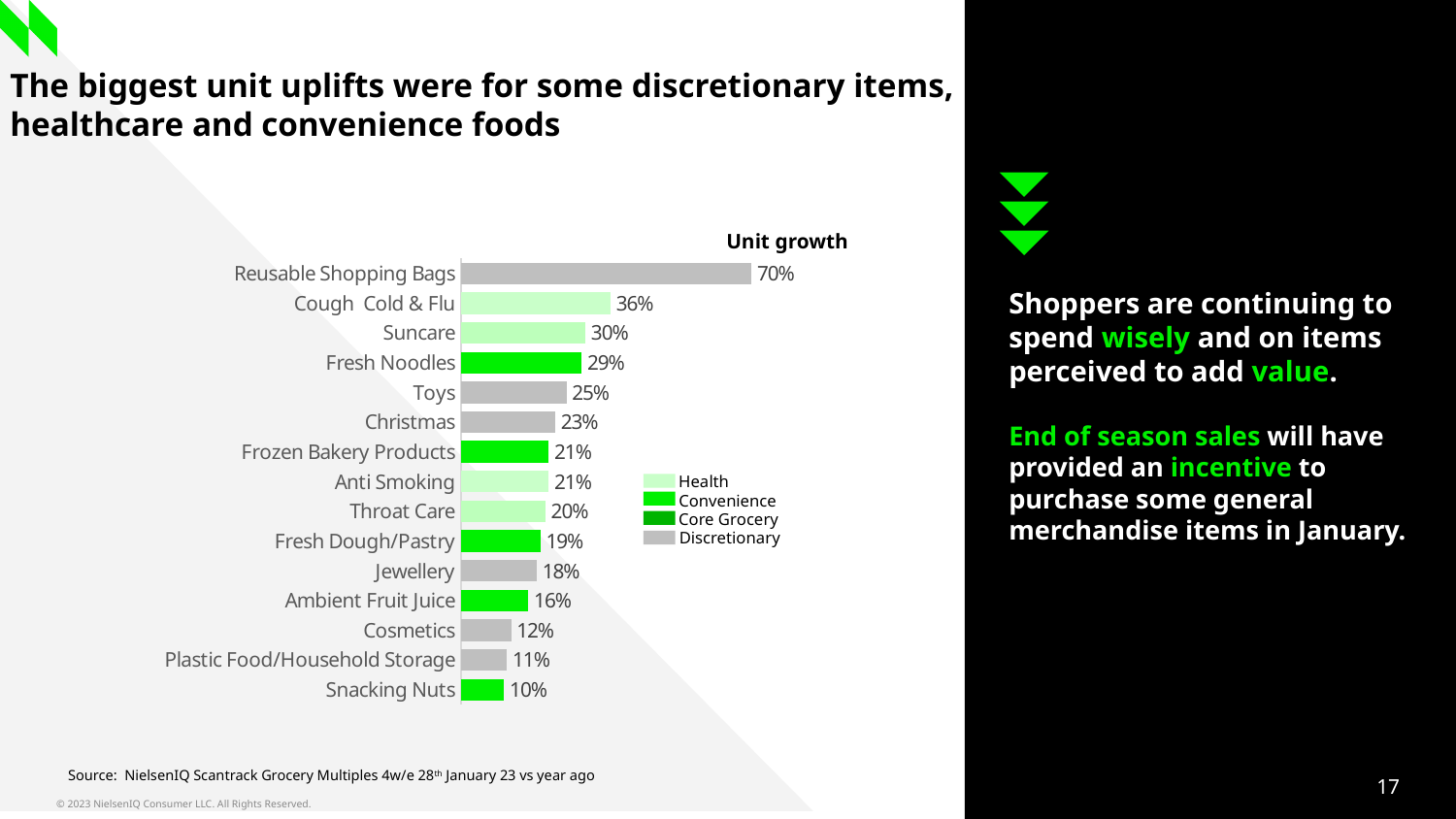
How many categories are shown in the chart? 15 What is the difference in unit growth between Cough Cold & Flu and Suncare? 6% Which category has the highest unit growth? Reusable Shopping Bags Which has higher unit growth, Christmas or Fresh Dough/Pastry? Christmas How many entries does the chart legend list? 4 What is the unit growth for Plastic Food/Household Storage? 11% What is the difference in unit growth between Reusable Shopping Bags and Toys? 45% What is the unit growth for Reusable Shopping Bags? 70% Which category has the lowest unit growth? Snacking Nuts What type of chart is shown on the slide? Bar chart Which has higher unit growth, Jewellery or Cosmetics? Jewellery What is the unit growth for Fresh Noodles? 29%